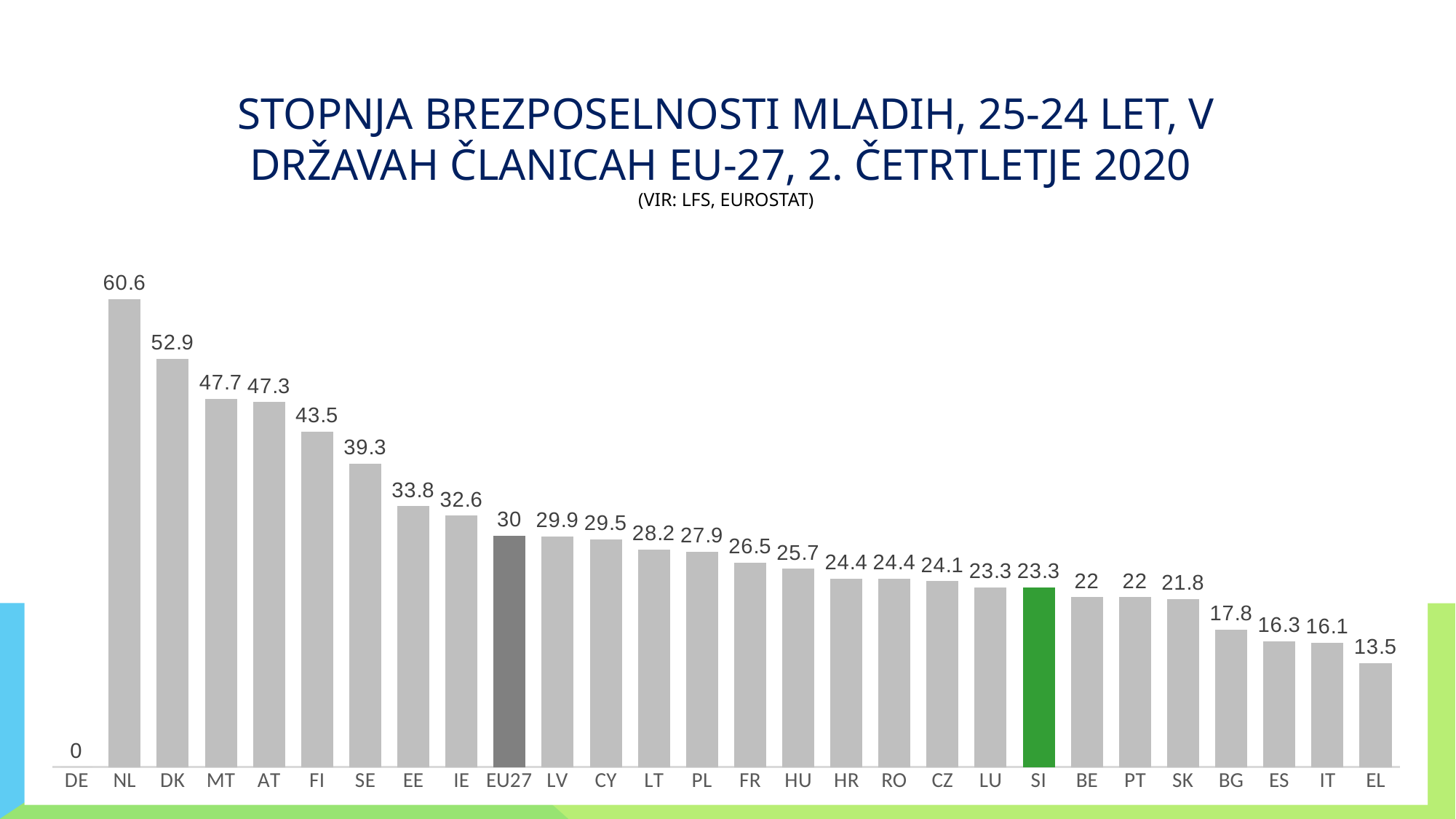
What kind of chart is this? bar chart What is the difference between the values for EU27 and SI? 6.7 Excluding DE, which category has the lowest value? EL What is the value for SI? 23.3 Which is larger, the value for EU27 or the value for SI? EU27 What is the value for NL? 60.6 Which bar is coloured green? SI What is the value for EL? 13.5 Which category has the highest value? NL What is the difference between the values for NL and SI? 37.3 What is the value for EU27? 30 How many categories are shown on the x axis? 28